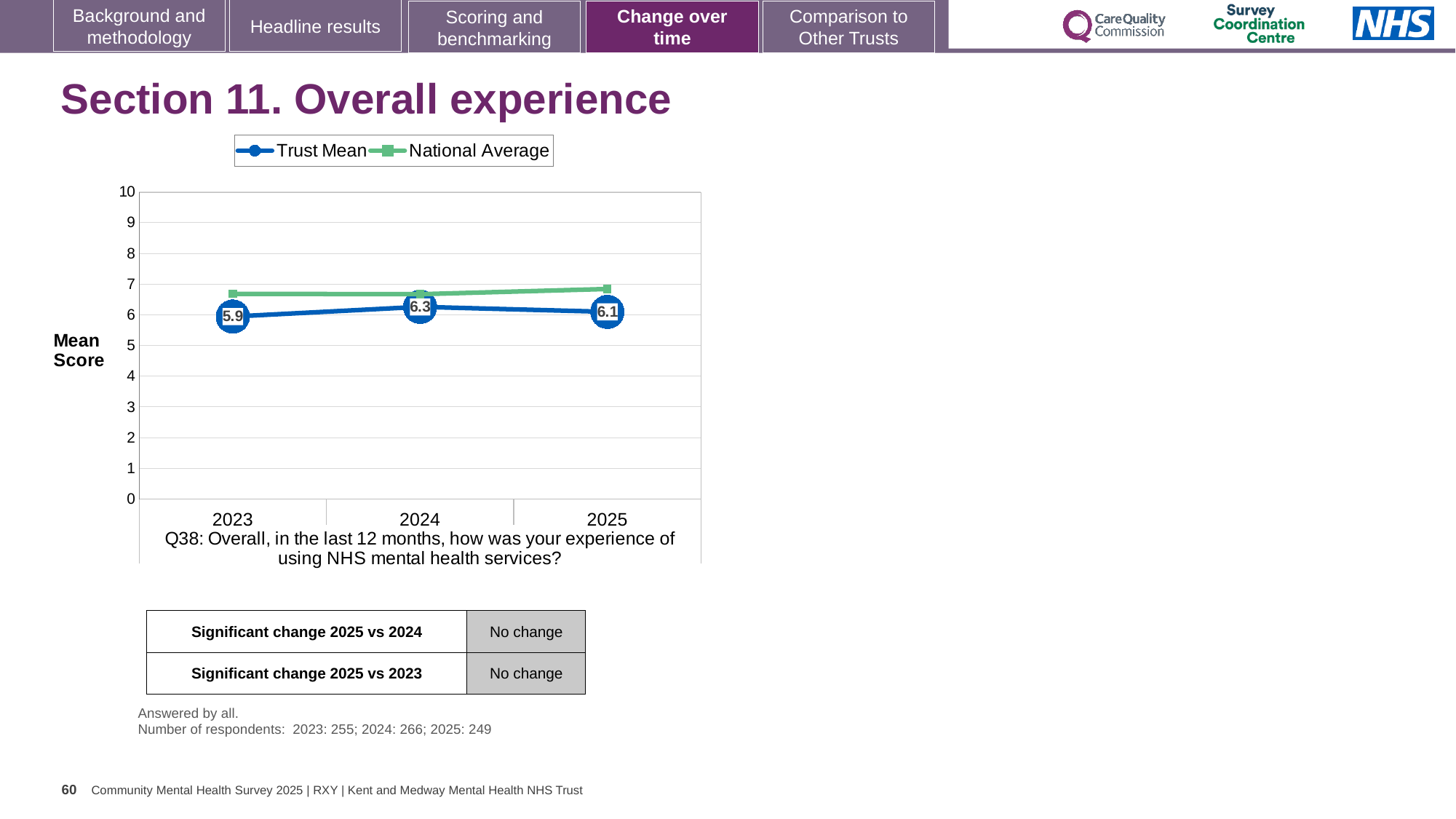
What is the Trust Mean score for 2025? 6.1 What is the difference between the Trust Mean in 2024 and in 2023? 0.4 What is the Trust Mean score for 2023? 5.9 How many series does the legend list? 2 Which is larger, the Trust Mean in 2025 or the Trust Mean in 2023? 2025 In which year is the Trust Mean lowest? 2023 What is the Trust Mean score for 2024? 6.3 What kind of chart is shown on the slide? line chart What is the label on the y axis of the chart? Mean Score Is the National Average value for 2025 greater or less than 6? greater How many years are plotted on the x axis? 3 In which year is the Trust Mean highest? 2024